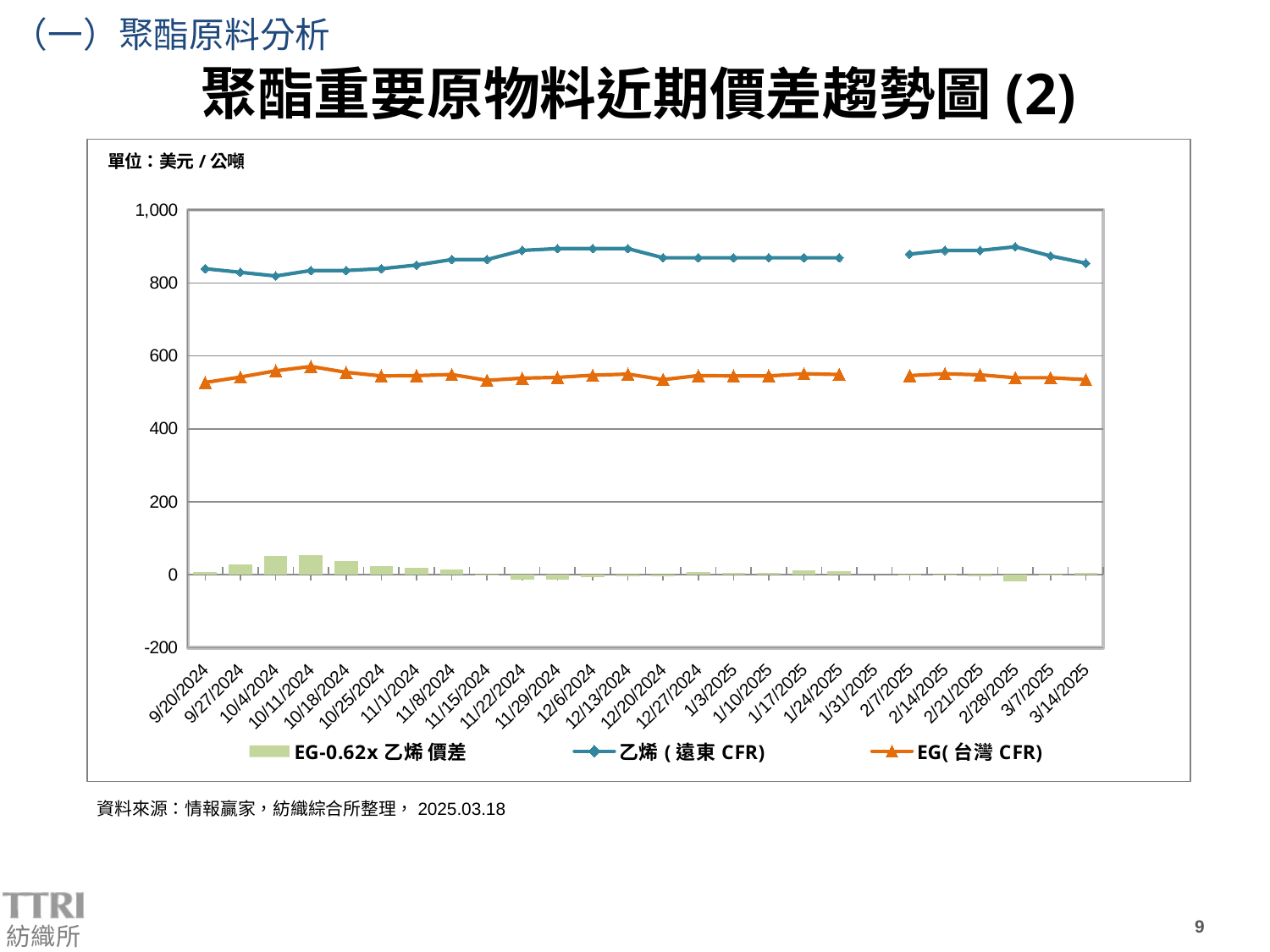
On which date is 乙烯 ( 遠東 CFR) at its lowest? 10/4/2024 What kind of chart is this? A combination bar and line chart What unit is stated for the values in the chart? 美元 / 公噸 On which date is EG( 台灣 CFR) at its highest? 10/11/2024 How many series does the legend list? 3 Is the value of 乙烯 ( 遠東 CFR) on 9/20/2024 greater or less than 800? greater Is the value of EG( 台灣 CFR) on 3/14/2025 greater or less than 400? greater Is the value of 乙烯 ( 遠東 CFR) on 12/13/2024 greater or less than 1,000? less Does 乙烯 ( 遠東 CFR) rise or fall from 10/4/2024 to 11/29/2024? rise How many dates are shown on the x axis? 26 On 12/13/2024, which is larger: 乙烯 ( 遠東 CFR) or EG( 台灣 CFR)? 乙烯 ( 遠東 CFR)